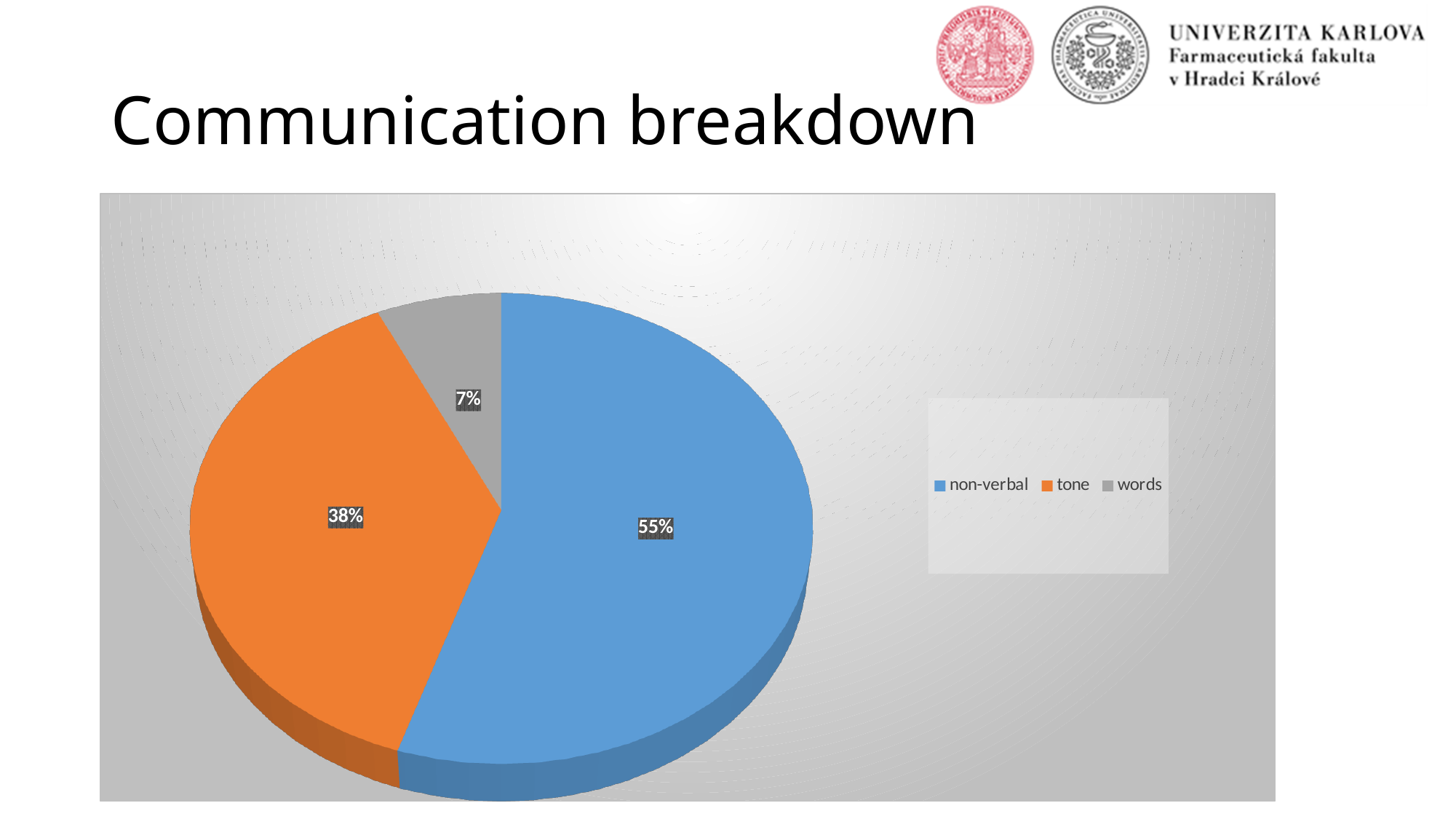
What colour is the slice for tone? orange What share of the pie does non-verbal communication account for? 55% Which is larger, the share for tone or the share for words? tone What percentage is shown for tone? 38% How many categories does the pie chart show? 3 Which category has the smallest slice of the pie? words What is the difference in percentage points between tone and words? 31 What kind of chart is shown on the slide? pie chart Which category has the largest slice of the pie? non-verbal What is the difference in percentage points between non-verbal and tone? 17 What is the title of the slide containing the chart? Communication breakdown What percentage is shown for words? 7%